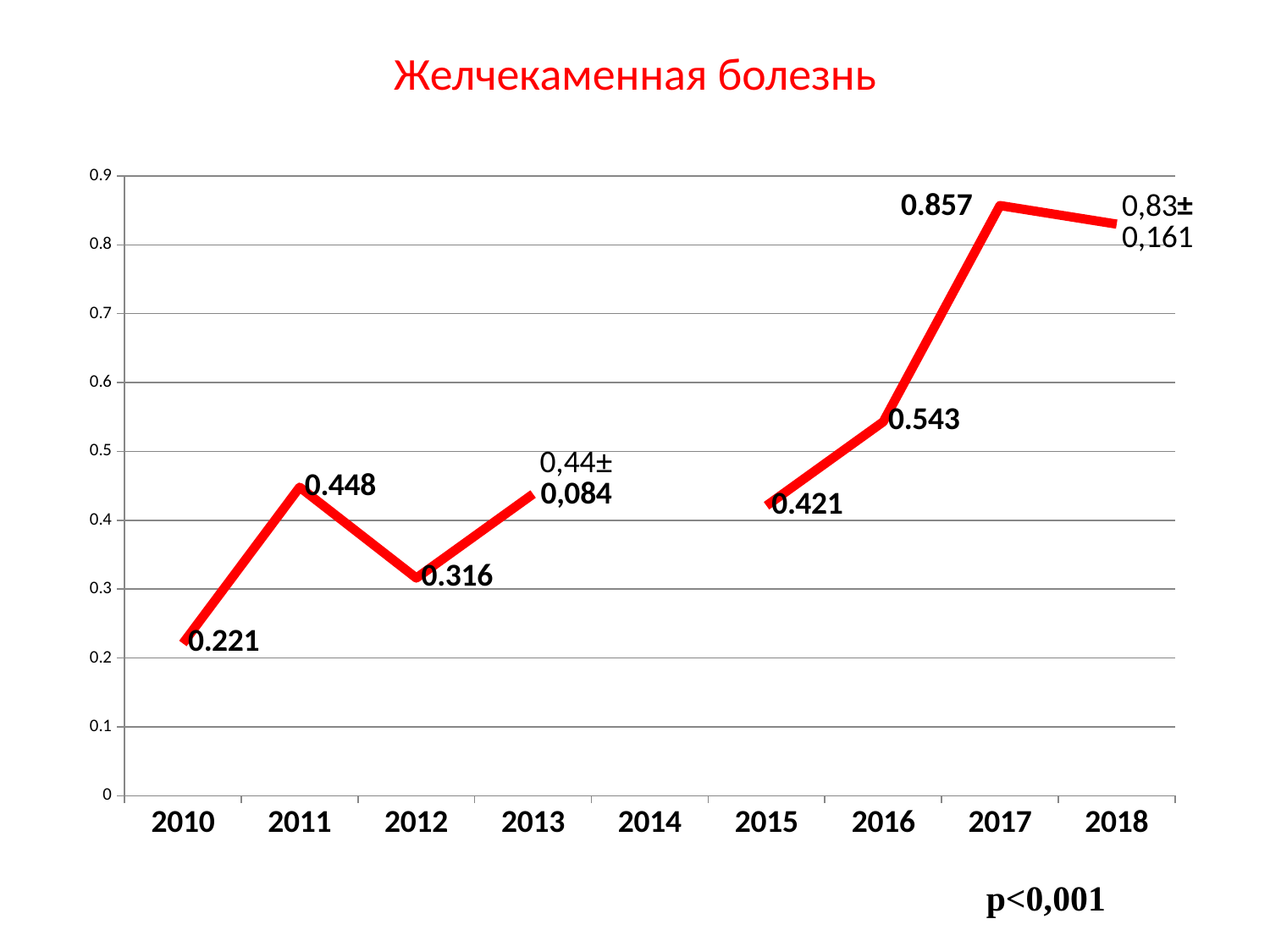
Is the value for 2016 greater or less than 0.5? greater Which year has the lowest value? 2010 Do the values rise or fall from 2015 to 2017? rise What kind of chart is shown on the slide? line chart Which year has the highest value? 2017 What is the value for 2017? 0.857 What is the difference between the values for 2016 and 2015? 0.122 Which year has the larger value, 2011 or 2012? 2011 What is the value for 2010? 0.221 How many years are labelled on the x axis? 9 What is the data label shown for 2018? 0,83±0,161 What is the data label shown for 2013? 0,44±0,084